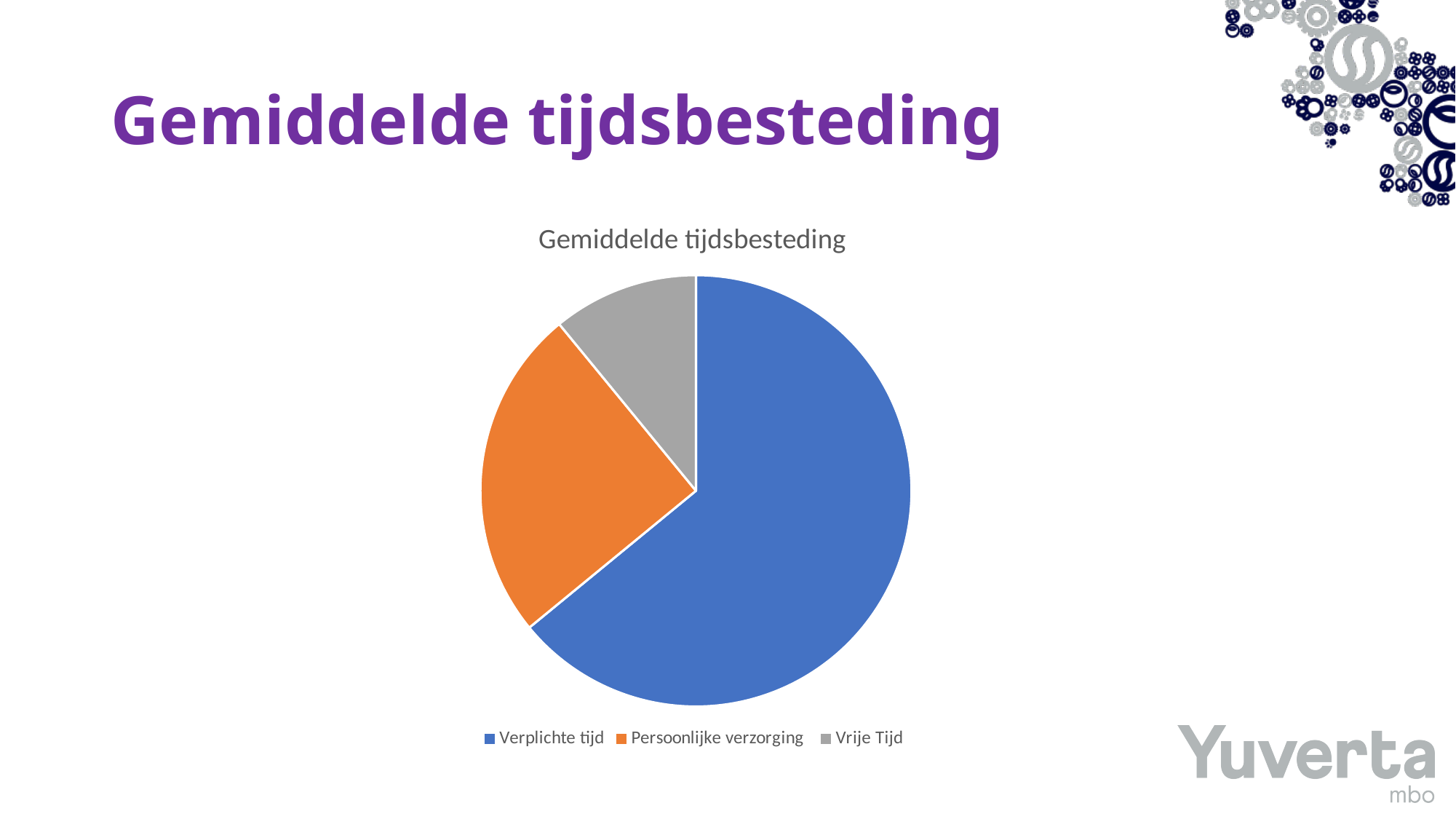
Does the Verplichte tijd slice take up more or less than half of the pie? more What kind of chart is shown on the slide? pie chart Which slice is larger: Verplichte tijd or Persoonlijke verzorging? Verplichte tijd How many categories (slices) does the pie chart have? 3 Which colour represents Persoonlijke verzorging in the pie chart? orange Which category has the largest slice of the pie? Verplichte tijd Which slice is larger: Persoonlijke verzorging or Vrije Tijd? Persoonlijke verzorging Which category has the smallest slice of the pie? Vrije Tijd What is the title of the chart? Gemiddelde tijdsbesteding